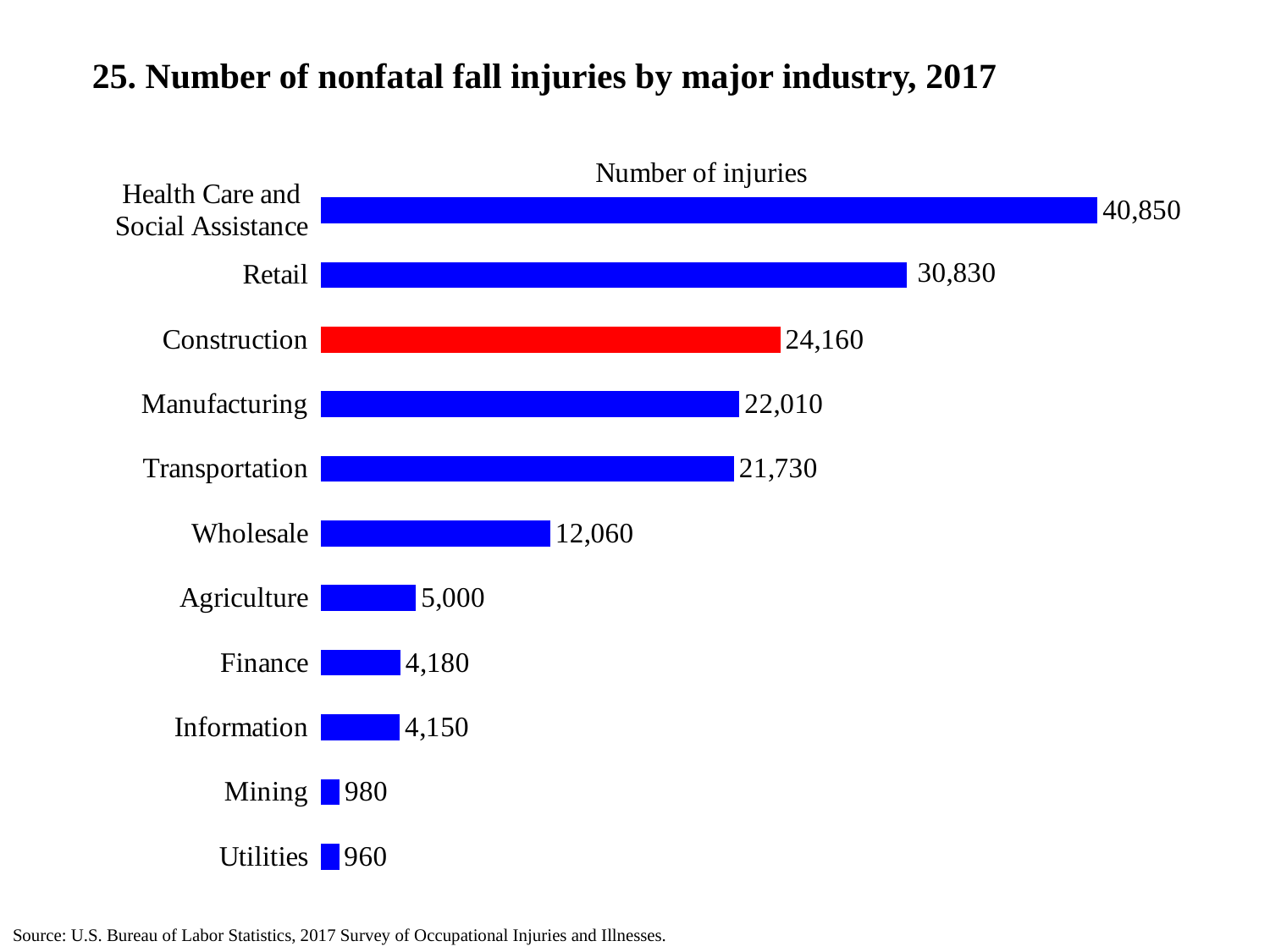
What kind of chart is shown on the slide? Bar chart What is the difference in nonfatal fall injuries between Health Care and Social Assistance and Retail? 10,020 What is the number of nonfatal fall injuries for Construction? 24,160 Which industry's bar is coloured red? Construction What is the number of nonfatal fall injuries for Mining? 980 Which has more nonfatal fall injuries, Retail or Construction? Retail Which has more nonfatal fall injuries, Wholesale or Agriculture? Wholesale How many industries are shown in the chart? 11 What is the difference in nonfatal fall injuries between Construction and Manufacturing? 2,150 Which industry has the highest number of nonfatal fall injuries? Health Care and Social Assistance Which industry has the lowest number of nonfatal fall injuries? Utilities What is the number of nonfatal fall injuries for Wholesale? 12,060